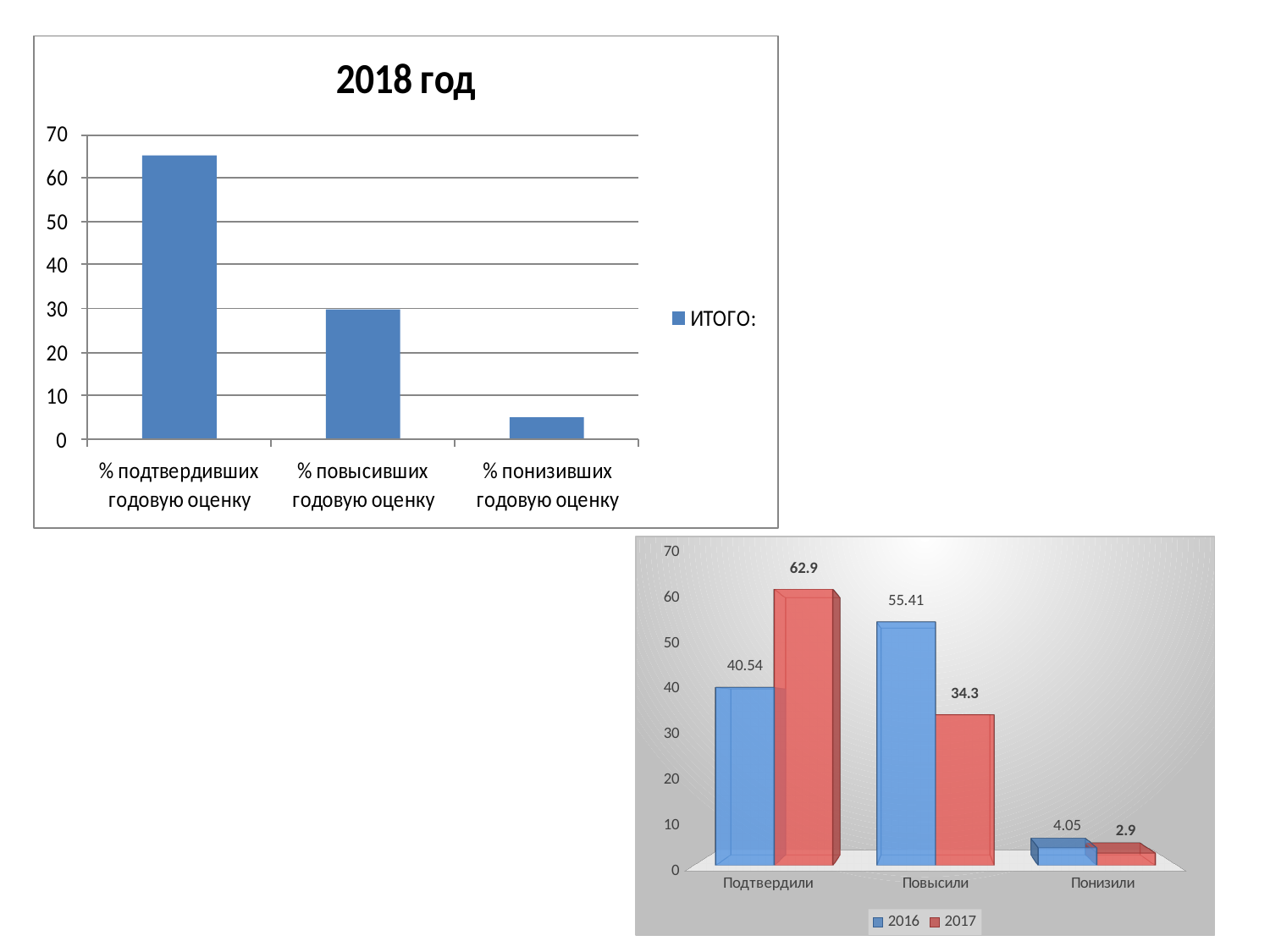
In the bottom-right chart, what is the value for 2016 in the Повысили category? 55.41 In the bottom-right chart, what is the value for 2016 in the Понизили category? 4.05 What kind of chart is the chart titled '2018 год'? bar chart In the chart titled '2018 год', which category has the highest value? % подтвердивших годовую оценку In the chart titled '2018 год', is the value for '% понизивших годовую оценку' greater or less than 10? less How many series does the legend of the bottom-right chart list? 2 In the bottom-right chart, which category has the lowest value for 2017? Понизили In the bottom-right chart, what is the difference between the 2017 and 2016 values for Подтвердили? 22.36 How many categories are shown in the chart titled '2018 год'? 3 In the bottom-right chart, what is the value for 2017 in the Подтвердили category? 62.9 In the bottom-right chart, which is larger for Повысили: the 2016 value or the 2017 value? 2016 In the chart titled '2018 год', is the value for '% повысивших годовую оценку' greater or less than 20? greater